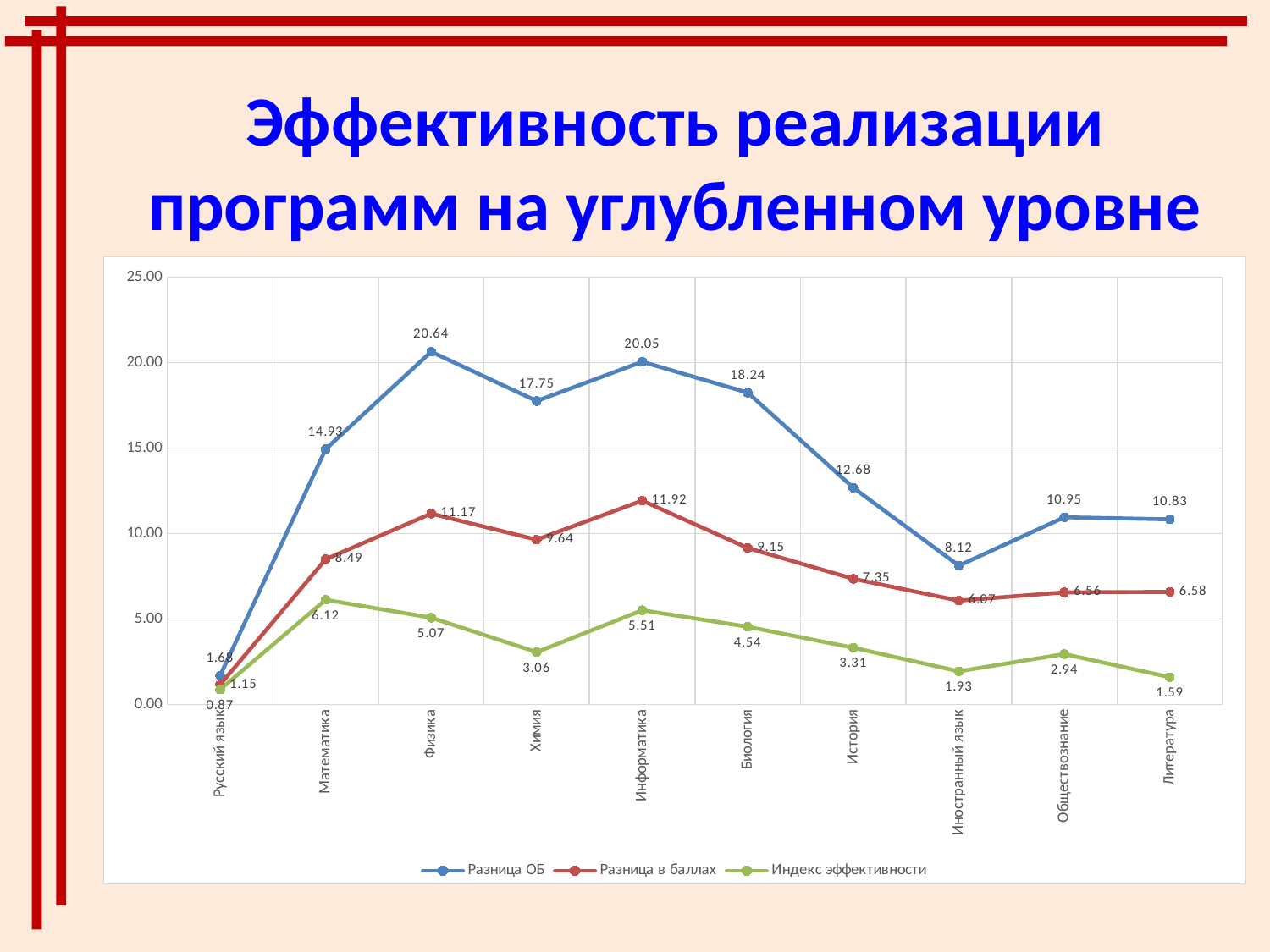
What is the value of Разница ОБ for Физика? 20.64 What is the value of Индекс эффективности for Химия? 3.06 What is the difference between the Разница ОБ values for Физика and Информатика? 0.59 Is the value of Разница ОБ for Иностранный язык greater or less than 10.00? less What is the value of Разница в баллах for Информатика? 11.92 Which subject has the lowest value for Индекс эффективности? Русский язык How many series does the legend list? 3 Which subject has the highest value for Индекс эффективности? Математика How many subjects (categories) are plotted along the x axis? 10 Which subject has the highest value for Разница ОБ? Физика Which is larger: Разница в баллах for Биология or for История? Биология What type of chart is shown on the slide? line chart